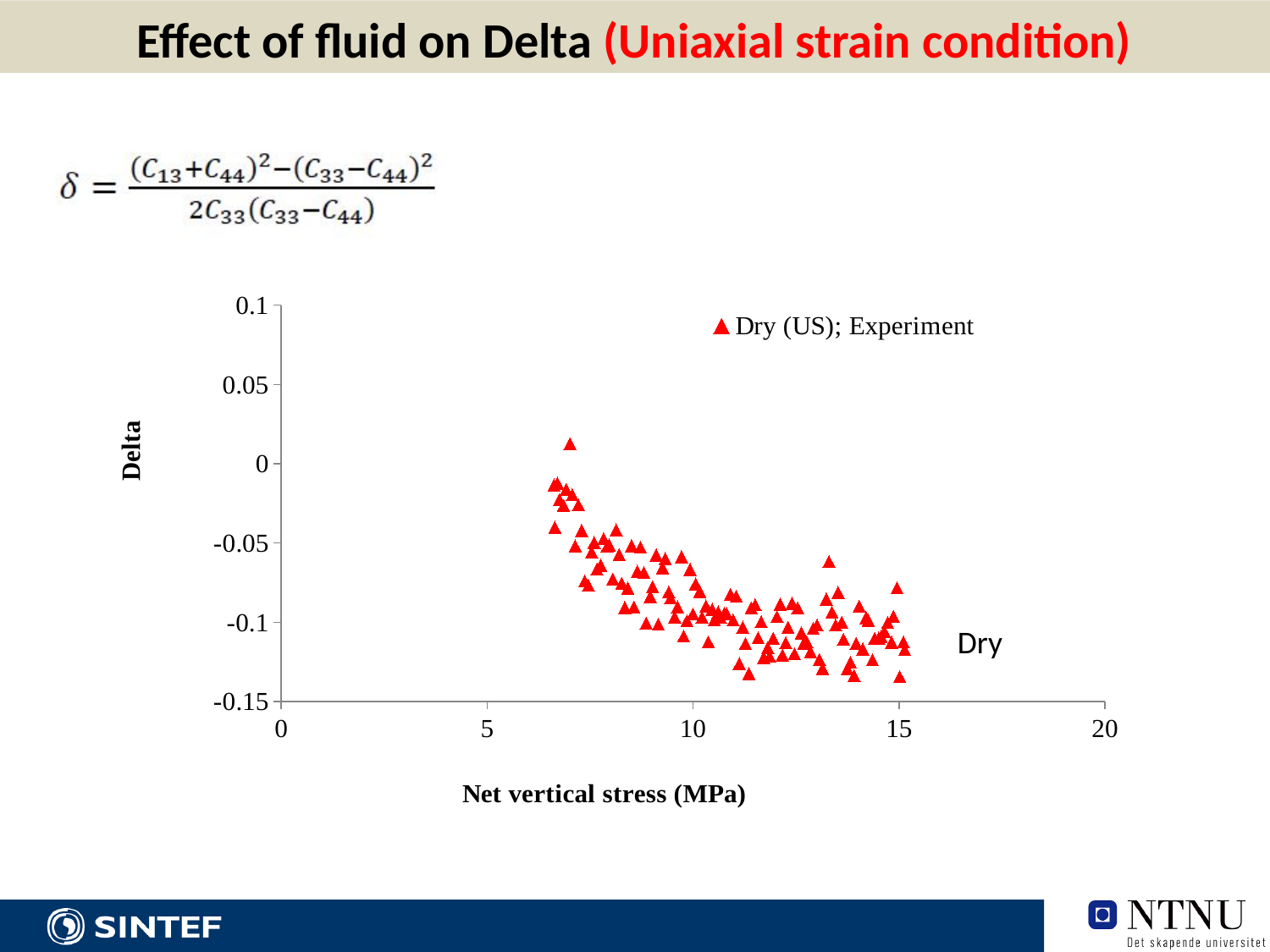
Are the Delta values plotted at a net vertical stress of about 15 MPa greater or less than 0? less Are the Delta values plotted at a net vertical stress of about 10 MPa greater or less than -0.15? greater What is the name of the series shown in the chart legend? Dry (US); Experiment What is the label of the x axis of the chart? Net vertical stress (MPa) Are the Delta values plotted at a net vertical stress of about 15 MPa greater or less than -0.05? less What kind of chart is shown on the slide? scatter plot Do the Delta values generally rise or fall as net vertical stress increases along the x axis? fall How many series does the chart legend list? 1